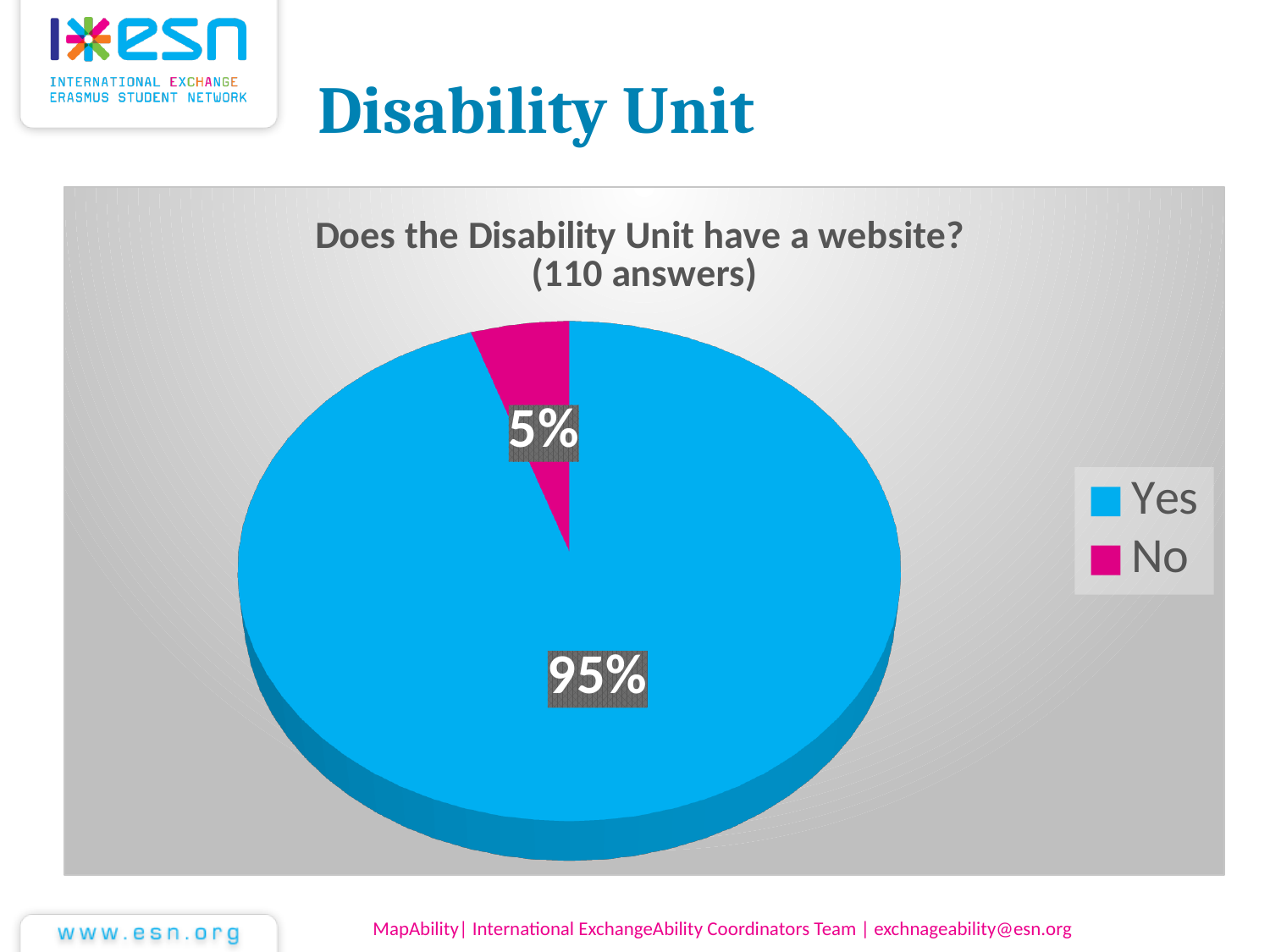
Which slice is larger, "Yes" or "No"? Yes What is the title of the chart? Does the Disability Unit have a website? (110 answers) How many answers does the chart title say were collected? 110 What percentage of answers were "No"? 5% What is the difference in percentage points between the "Yes" and "No" slices? 90 Which category has the largest share of the pie? Yes What kind of chart is shown on the slide? Pie chart What percentage of answers were "Yes"? 95% Which category has the smallest share of the pie? No What colour is the "No" slice? Pink How many categories does the pie chart show? 2